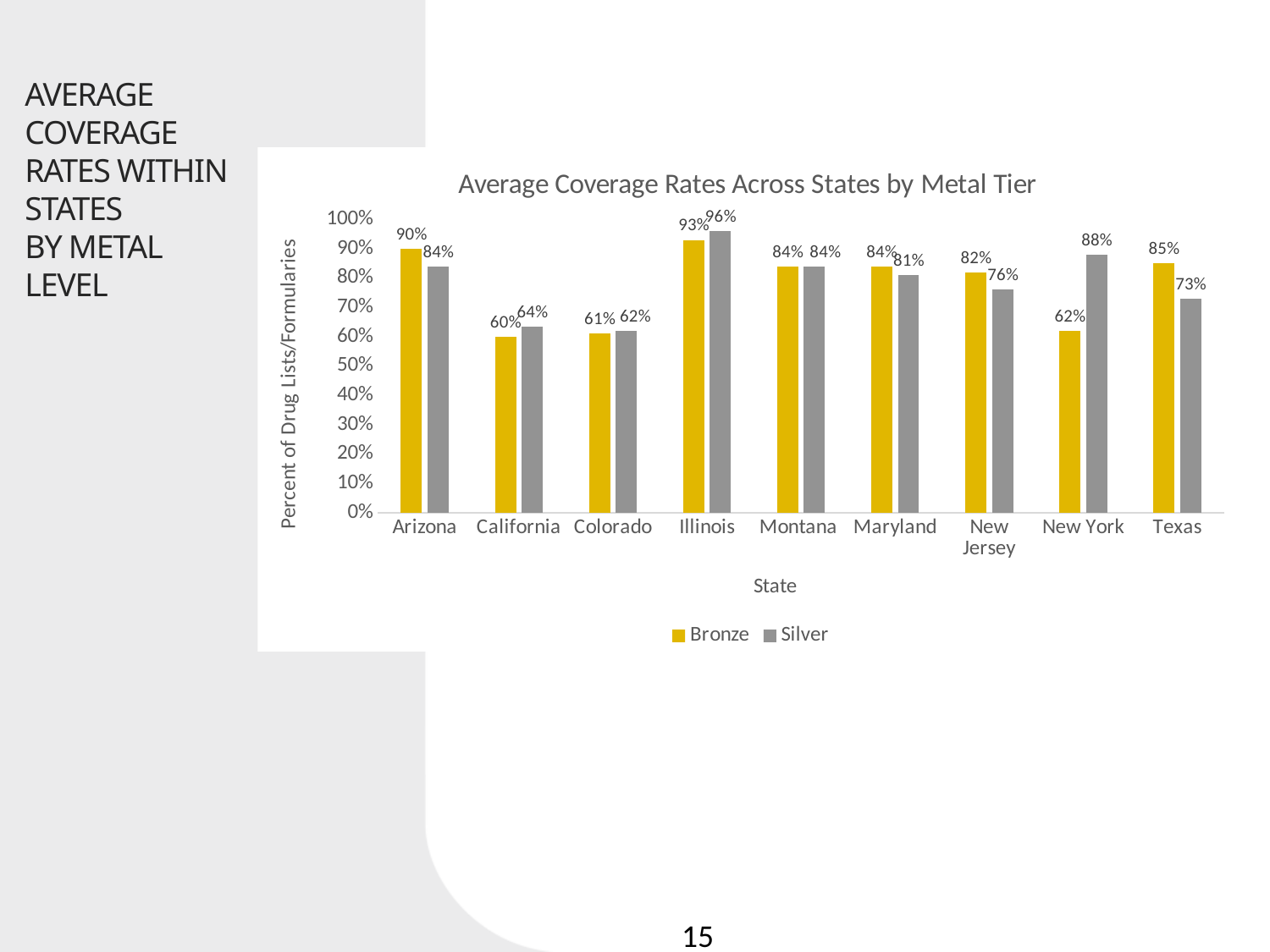
What is the difference between the Silver and Bronze coverage rates for New York? 26% What is the Silver coverage rate for New York? 88% How many states are shown on the x axis? 9 Which is larger for Texas, the Bronze or the Silver coverage rate? Bronze Which state has the highest Silver coverage rate? Illinois How many series does the legend list? 2 Is the Bronze coverage rate for New Jersey greater or less than 70%? greater What kind of chart is shown on the slide? Bar chart What is the Bronze coverage rate for Arizona? 90% What is the title of the chart? Average Coverage Rates Across States by Metal Tier What is the Silver coverage rate for Texas? 73% Which state has the lowest Bronze coverage rate? California